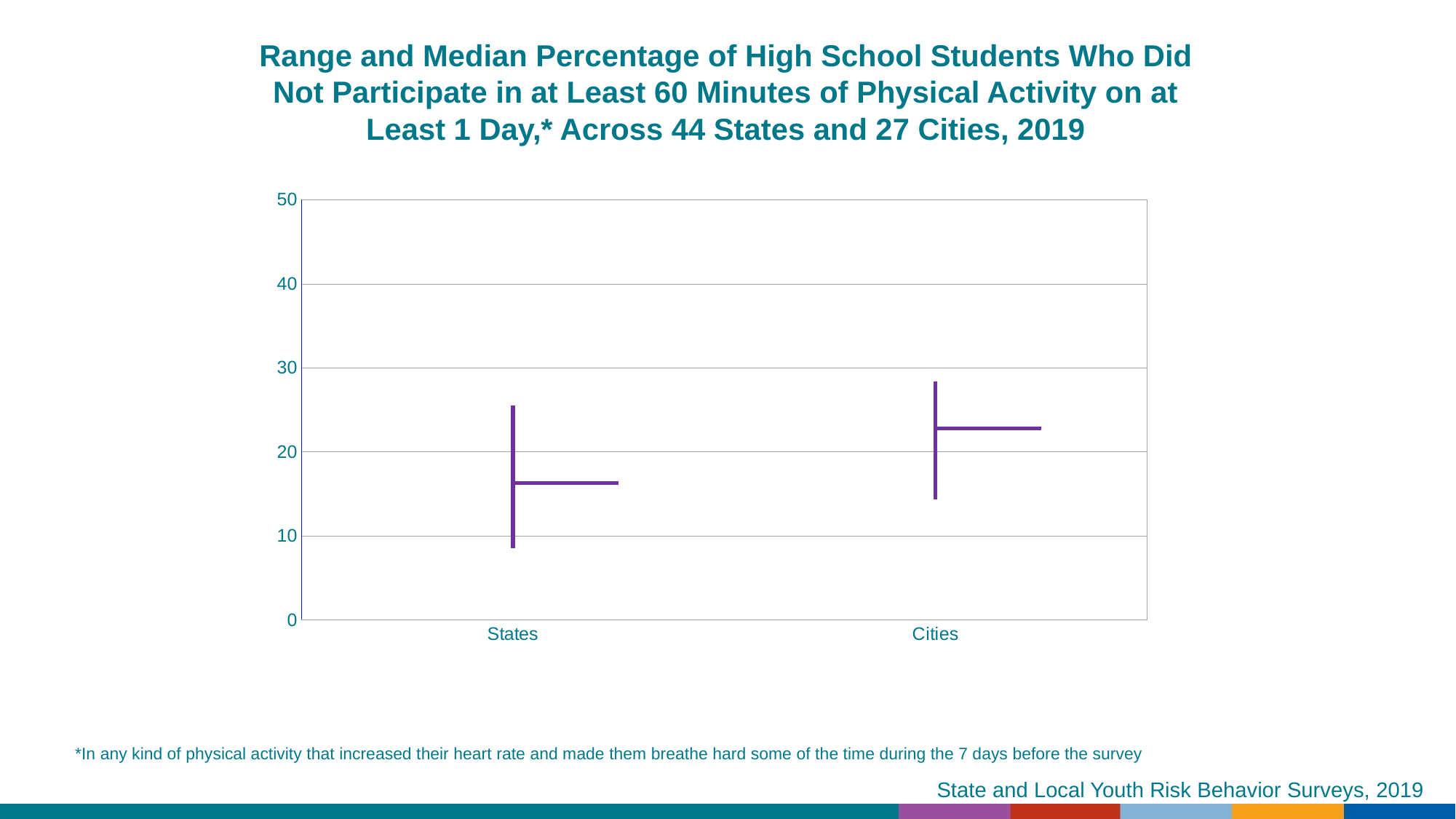
Is the bottom of the range for Cities greater or less than 10? greater Is the median value for States greater or less than 20? less Is the top of the range for States greater or less than 30? less Which category has the higher maximum (top of the range), States or Cities? Cities Which category has the lower minimum (bottom of the range), States or Cities? States According to the chart title, how many states and how many cities are included? 44 states and 27 cities How many categories are shown on the x axis of the chart? 2 What is the highest value shown on the y axis of the chart? 50 Which category has the higher median percentage, States or Cities? Cities What are the two categories shown on the x axis? States and Cities